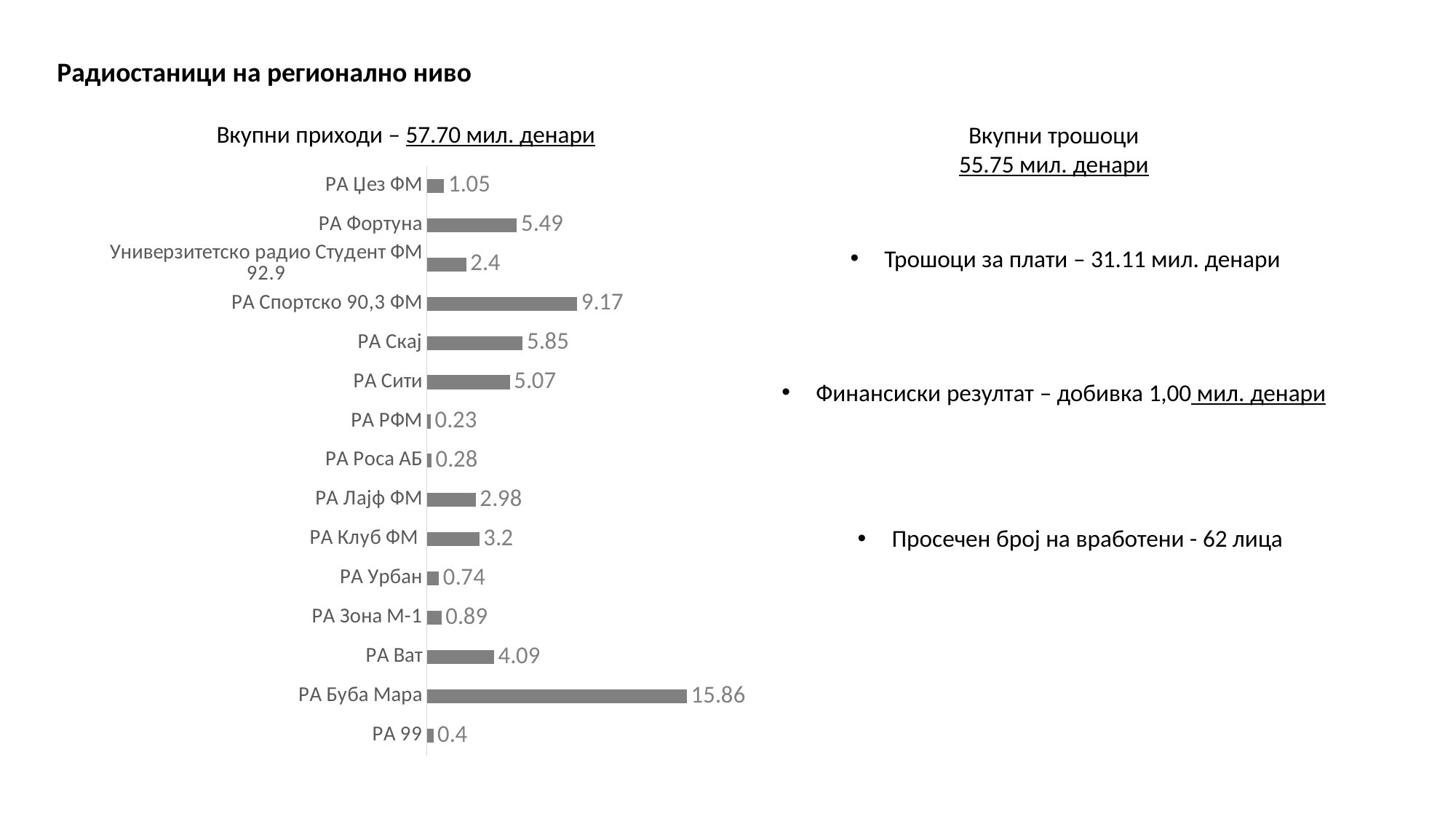
What is the value shown for Универзитетско радио Студент ФМ 92.9? 2.4 What is the value shown for РА Спортско 90,3 ФМ? 9.17 What total revenue figure is given in the chart's title? 57.70 мил. денари What kind of chart is shown on the slide? Bar chart Which radio station has the highest value in the chart? РА Буба Мара What is the difference between the values for РА Скај and РА Сити? 0.78 Which has a larger value, РА Фортуна or РА Ват? РА Фортуна Which radio station has the lowest value in the chart? РА РФМ How many radio stations are shown in the chart? 15 What is the value shown for РА Буба Мара? 15.86 What is the value shown for РА Клуб ФМ? 3.2 What is the difference between the values for РА Буба Мара and РА Спортско 90,3 ФМ? 6.69